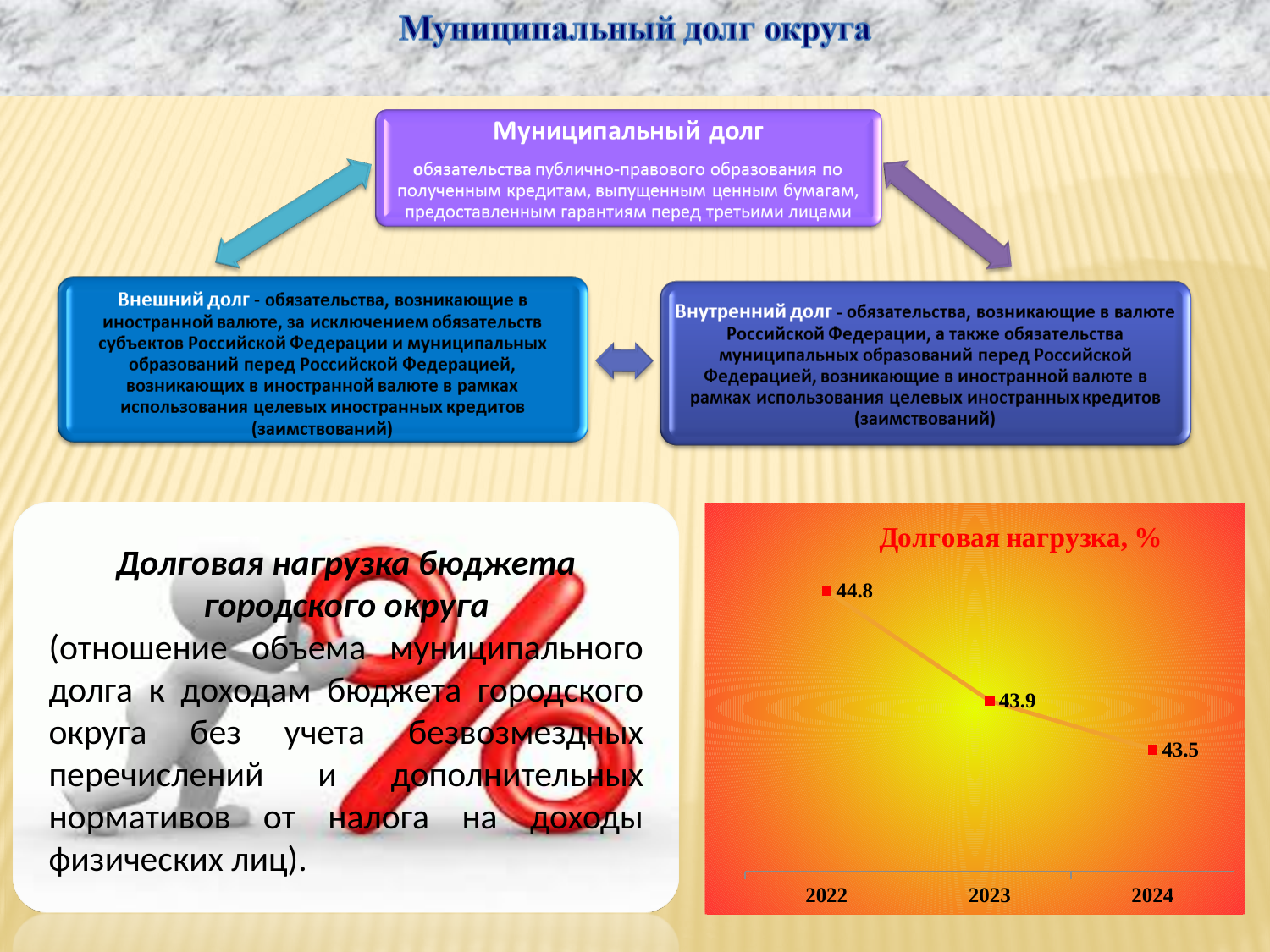
What kind of chart is "Долговая нагрузка, %"? Line chart Do the values in the chart "Долговая нагрузка, %" rise or fall from 2022 to 2024? Fall What is the difference between the 2022 and 2024 values in the chart "Долговая нагрузка, %"? 1.3 What is the value for 2022 in the chart "Долговая нагрузка, %"? 44.8 What is the difference between the 2022 and 2023 values in the chart "Долговая нагрузка, %"? 0.9 How many data points are plotted in the chart "Долговая нагрузка, %"? 3 What is the title of the chart in the lower right of the slide? Долговая нагрузка, % Which year has the lowest value in the chart "Долговая нагрузка, %"? 2024 In the chart "Долговая нагрузка, %", which is larger: the value for 2023 or the value for 2024? 2023 What is the value for 2024 in the chart "Долговая нагрузка, %"? 43.5 What is the value for 2023 in the chart "Долговая нагрузка, %"? 43.9 Which year has the highest value in the chart "Долговая нагрузка, %"? 2022